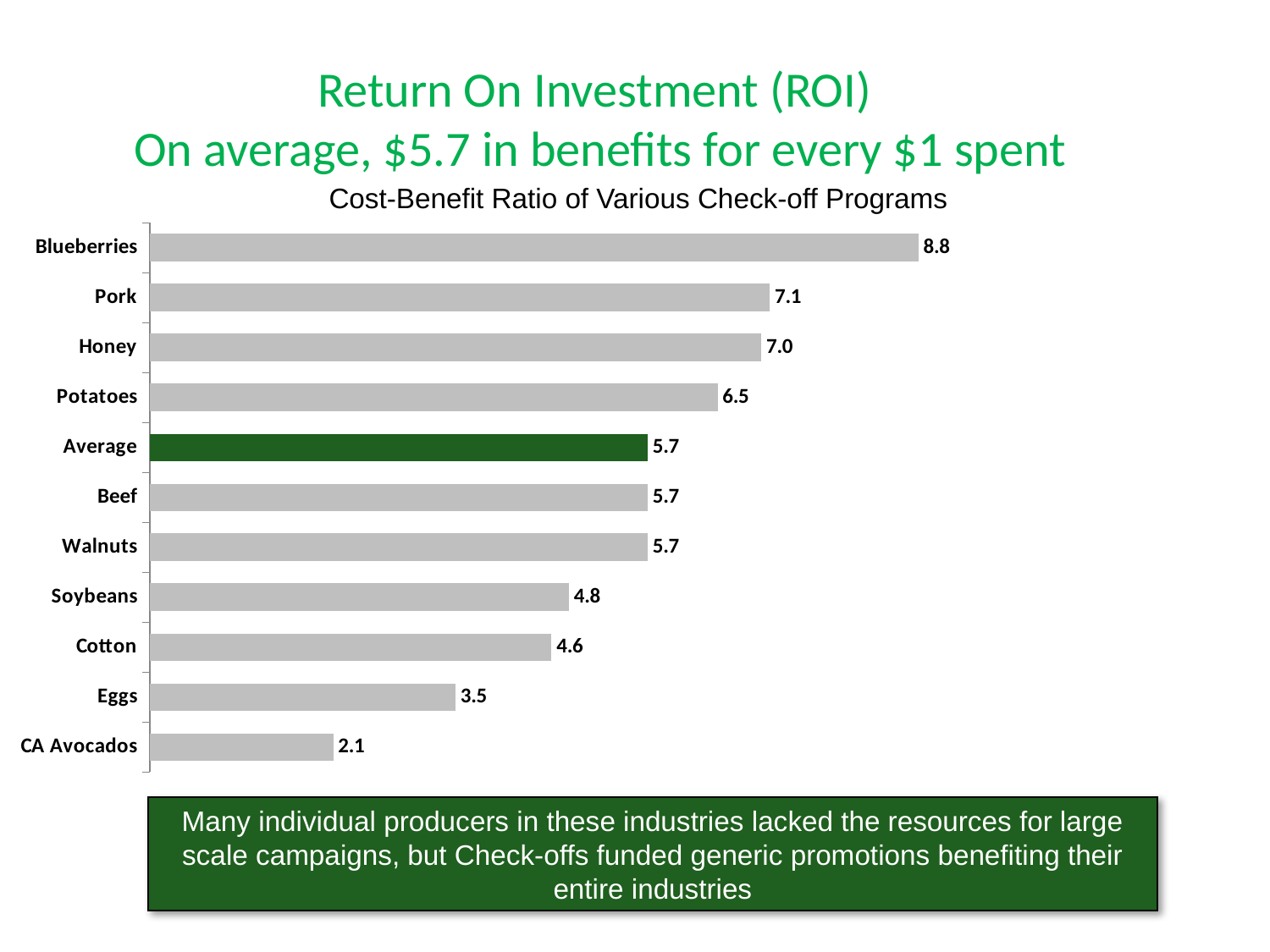
What is the difference between the values for Blueberries and CA Avocados? 6.7 Which bar is coloured dark green instead of grey? Average What is the difference between the values for Pork and Potatoes? 0.6 What is the value shown for Eggs? 3.5 What is the cost-benefit ratio for Blueberries? 8.8 Which category has the highest cost-benefit ratio? Blueberries What kind of chart is shown on the slide? Bar chart What is the title of the chart? Cost-Benefit Ratio of Various Check-off Programs Which has a higher cost-benefit ratio, Honey or Soybeans? Honey How many bars are shown in the chart? 11 Which category has the lowest cost-benefit ratio? CA Avocados What is the cost-benefit ratio for Cotton? 4.6